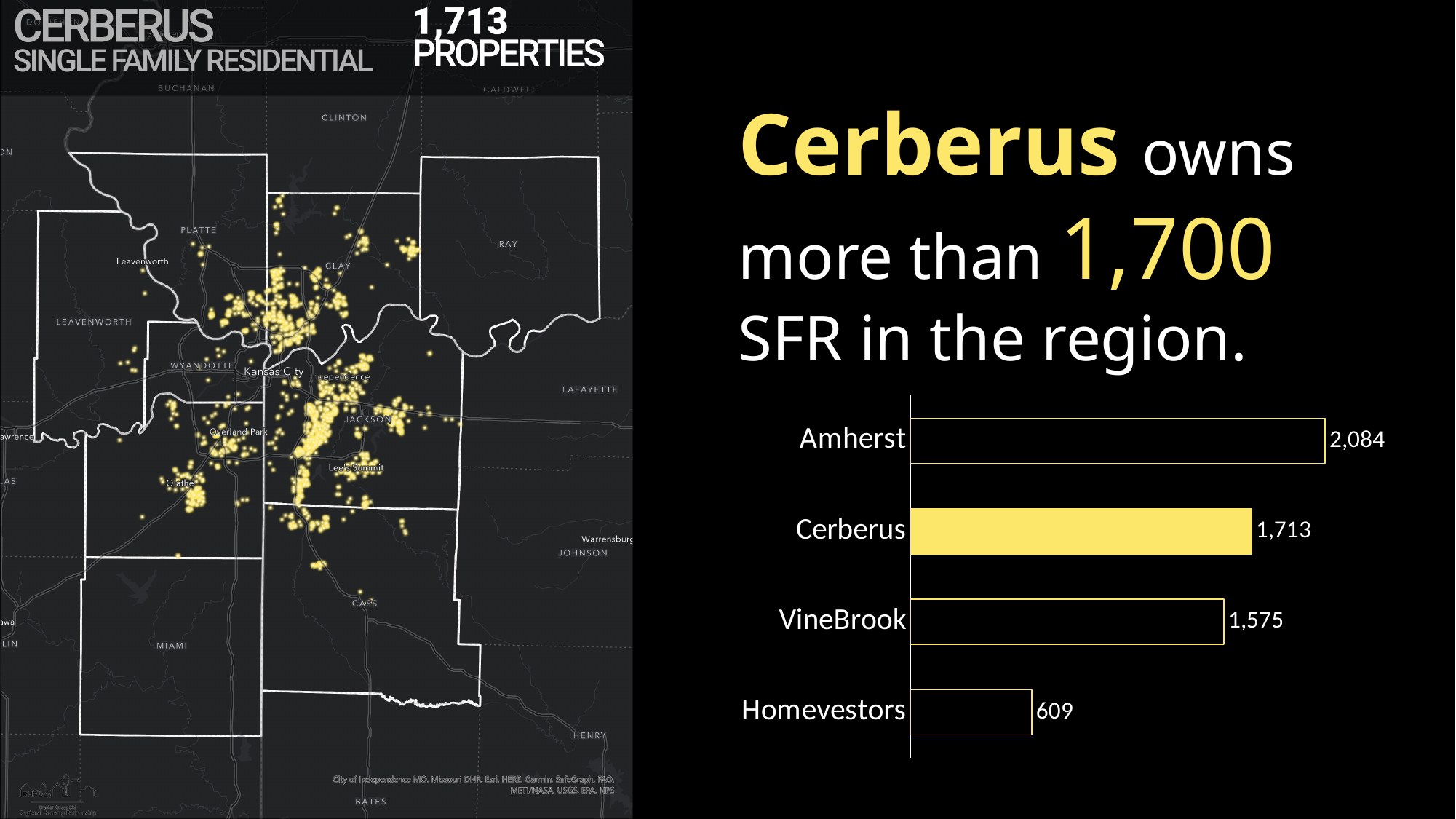
What value is shown for Homevestors in the bar chart? 609 Which bar in the chart is filled in solid yellow? Cerberus What value is shown for Amherst in the bar chart? 2,084 What value is shown for Cerberus in the bar chart? 1,713 Which category has the lowest value in the bar chart? Homevestors What is the difference between the values for Cerberus and VineBrook? 138 What is the difference between the values for Amherst and Cerberus? 371 Which is larger, the value for VineBrook or the value for Homevestors? VineBrook How many categories are shown in the bar chart? 4 Which category has the highest value in the bar chart? Amherst What value is shown for VineBrook in the bar chart? 1,575 What kind of chart is shown on the right side of the slide? Bar chart